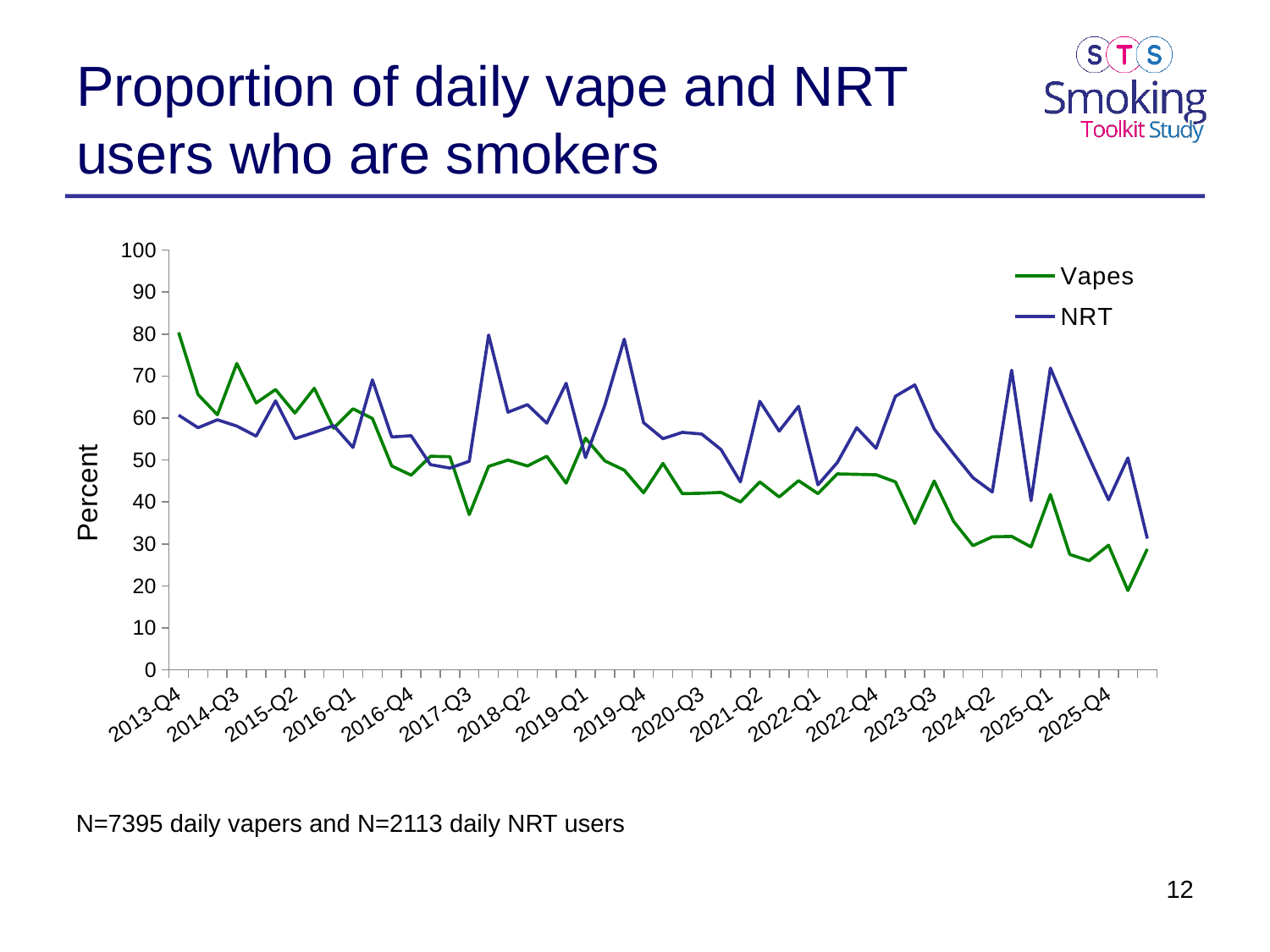
Is the value for NRT at 2013-Q4 greater or less than 50? greater What kind of chart is shown on the slide? Line chart At 2013-Q4, which series has the higher value, Vapes or NRT? Vapes Does the Vapes series generally rise or fall from 2013-Q4 to 2025-Q4? Fall What are the two series named in the legend? Vapes and NRT At which x-axis label does the Vapes series reach its highest value? 2013-Q4 Is the value for Vapes at 2013-Q4 greater or less than 70? greater What is the label on the vertical axis? Percent Is the value for NRT at 2019-Q4 greater or less than 70? less How many series does the legend list? 2 At 2019-Q4, which series has the higher value, Vapes or NRT? NRT